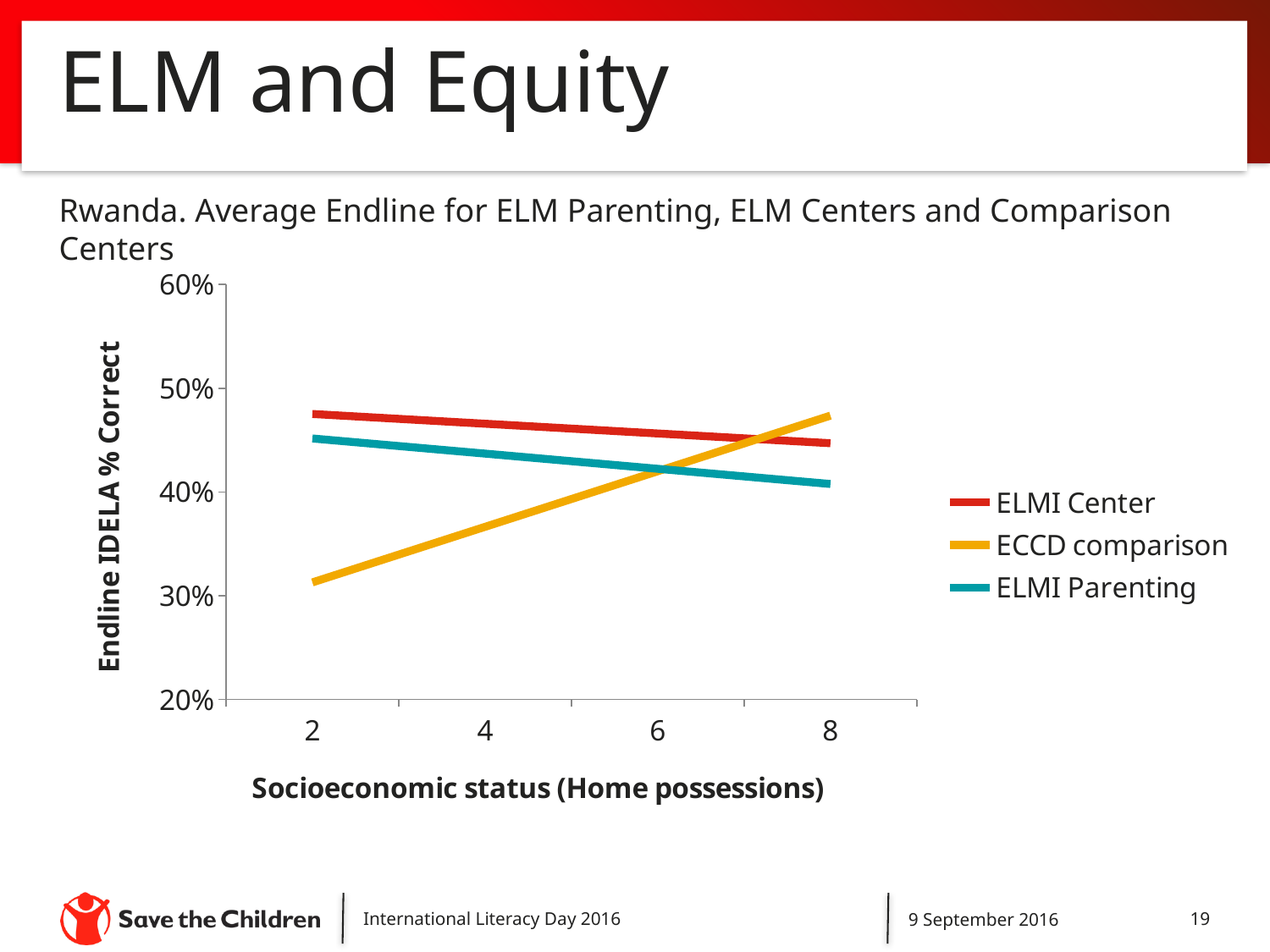
How many series does the legend list? 3 Does the ELMI Parenting line rise or fall as socioeconomic status increases from 2 to 8? falls At socioeconomic status 2, which is larger: ELMI Center or ECCD comparison? ELMI Center Which series has the lowest value at socioeconomic status 2? ECCD comparison Is the value for ELMI Center at socioeconomic status 2 greater or less than 40%? greater Does the ELMI Center line rise or fall as socioeconomic status increases from 2 to 8? falls At socioeconomic status 8, which is larger: ECCD comparison or ELMI Parenting? ECCD comparison Is the value for ECCD comparison at socioeconomic status 2 greater or less than 40%? less Is the value for ELMI Parenting at socioeconomic status 8 greater or less than 50%? less What kind of chart is shown on the slide? line chart What is the title of the vertical axis? Endline IDELA % Correct Does the ECCD comparison line rise or fall as socioeconomic status increases from 2 to 8? rises